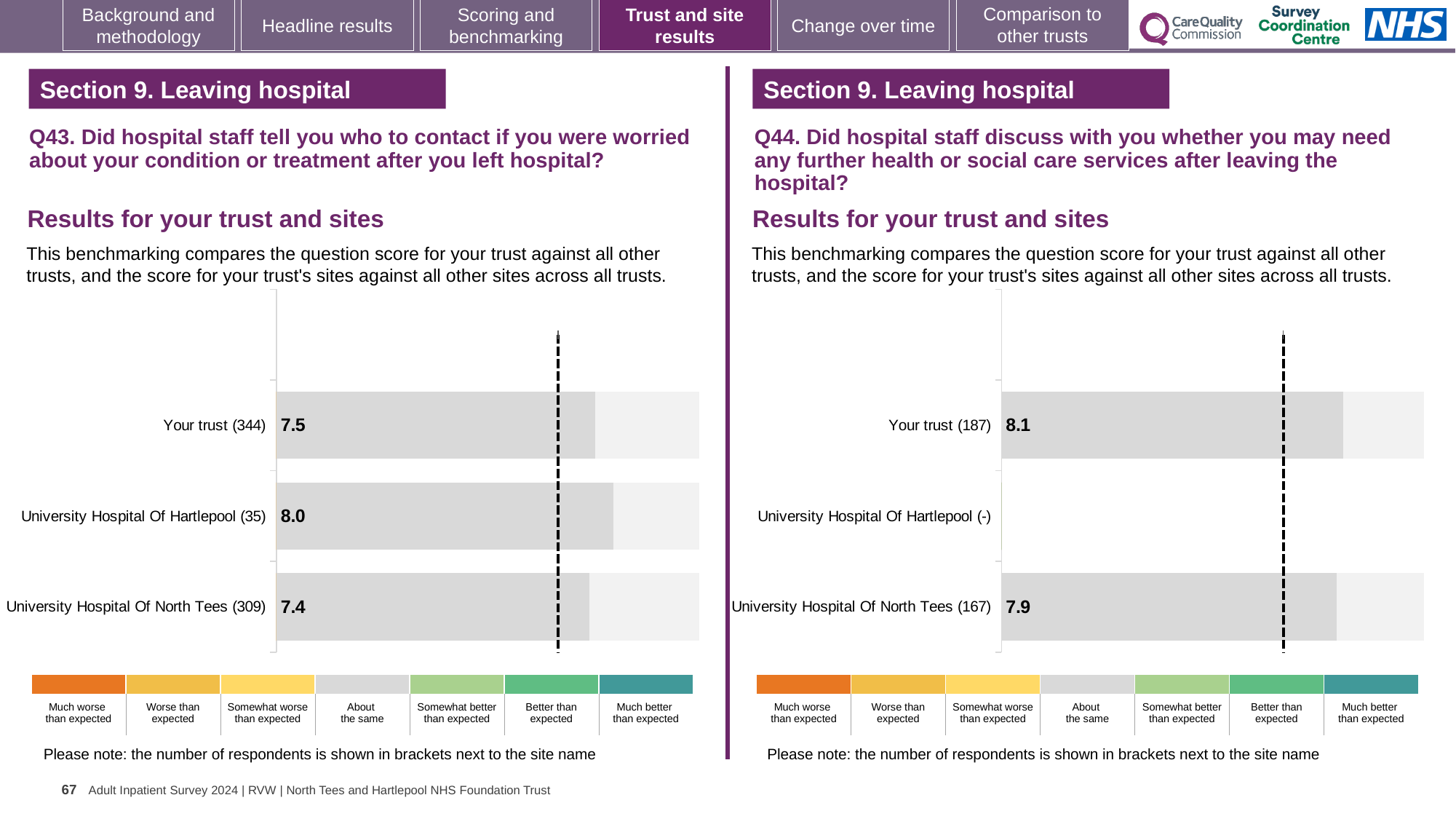
What kind of chart is used on the Q43 chart (left)? Bar chart On the Q43 chart (left), what is the difference between the scores for University Hospital Of Hartlepool (35) and University Hospital Of North Tees (309)? 0.6 On the Q44 chart (right), what is the score for University Hospital Of North Tees (167)? 7.9 On the Q44 chart (right), what is the difference between the scores for Your trust (187) and University Hospital Of North Tees (167)? 0.2 How many categories (trust and sites) are listed on the Q43 chart (left)? 3 On the Q44 chart (right), what is the score for Your trust (187)? 8.1 On the Q43 chart (left), what is the score for University Hospital Of North Tees (309)? 7.4 On the Q44 chart (right), which is larger, the score for Your trust (187) or for University Hospital Of North Tees (167)? Your trust (187) On the Q43 chart (left), which site or trust has the lowest score? University Hospital Of North Tees (309) On the Q43 chart (left), which site or trust has the highest score? University Hospital Of Hartlepool (35) On the Q43 chart (left), what is the score for University Hospital Of Hartlepool (35)? 8.0 On the Q43 chart (left), what is the score for Your trust (344)? 7.5